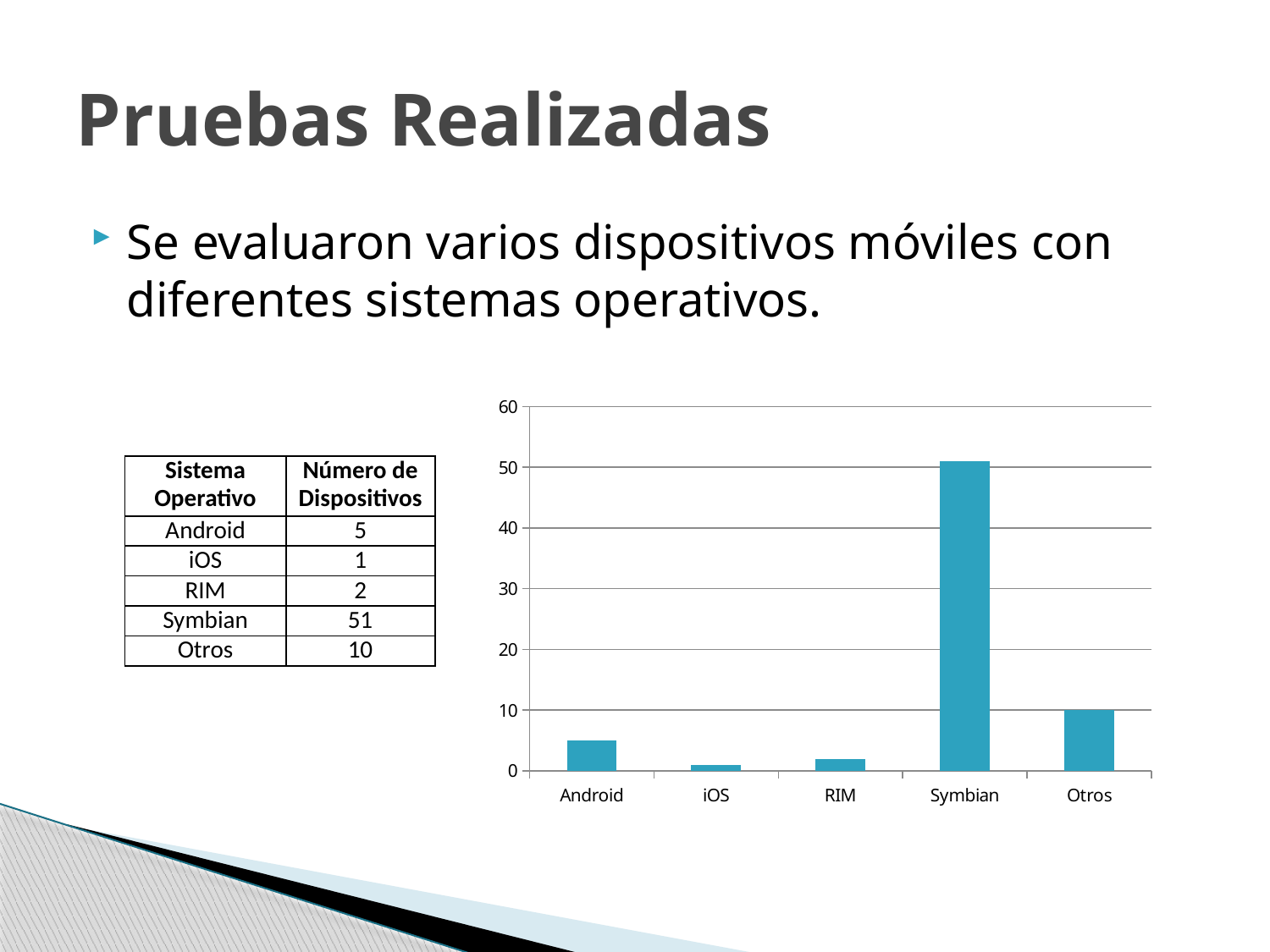
Is the value for Symbian greater or less than 50? greater Which category has the highest bar in the chart? Symbian How many categories are shown on the x axis of the bar chart? 5 Is the value for Android greater or less than 10? less Which category has the lowest bar in the chart? iOS What is the highest value shown on the y axis of the chart? 60 What is the number of devices for Android? 5 What is the number of devices for Otros? 10 What kind of chart is shown on the slide? bar chart Which is larger, the value for Android or the value for RIM? Android What is the number of devices for Symbian? 51 What is the difference between the values for Symbian and Otros? 41